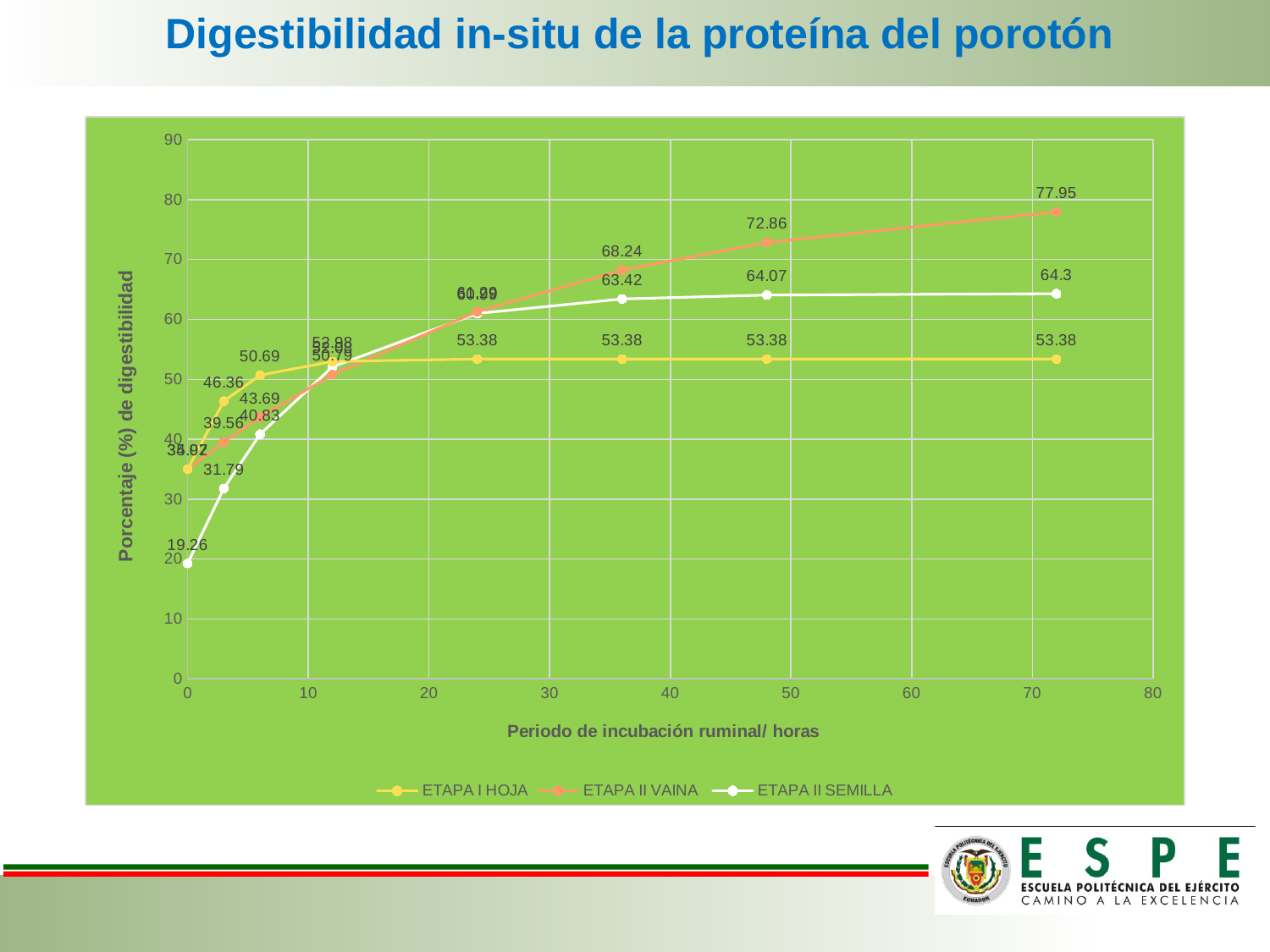
What is the value for ETAPA II VAINA at 72 hours? 77.95 How many series does the legend list? 3 What is the title of the x axis? Periodo de incubación ruminal/ horas Which series has the lowest value at 0 hours? ETAPA II SEMILLA What type of chart is shown on the slide? line chart What is the value for ETAPA II VAINA at 48 hours? 72.86 Which series has the highest value at 72 hours? ETAPA II VAINA What is the value for ETAPA II SEMILLA at 72 hours? 64.3 What is the value for ETAPA I HOJA at 72 hours? 53.38 What is the difference between ETAPA II VAINA and ETAPA I HOJA at 72 hours? 24.57 Does the value for ETAPA II VAINA rise or fall as the incubation period increases? rise What is the value for ETAPA II SEMILLA at 0 hours? 19.26